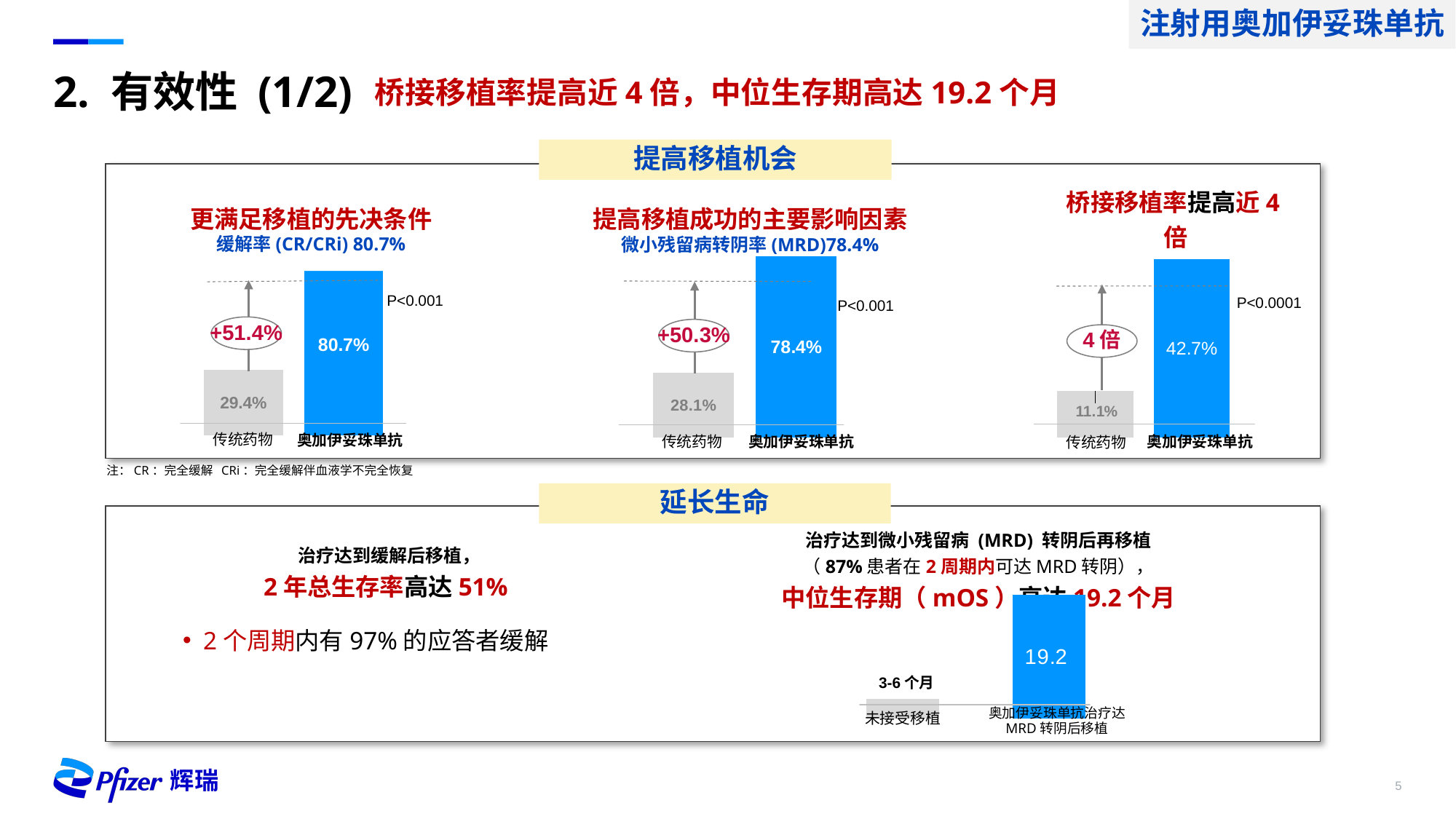
In the top-right chart (桥接移植率), which category has the higher value, 传统药物 or 奥加伊妥珠单抗? 奥加伊妥珠单抗 In the top-left chart (缓解率 CR/CRi), what is the value for 传统药物? 29.4% In the top-right chart (桥接移植率), what is the value for 奥加伊妥珠单抗? 42.7% In the top-middle chart (微小残留病转阴率 MRD), what is the value for 奥加伊妥珠单抗? 78.4% In the top-right chart (桥接移植率), what is the value for 传统药物? 11.1% In the top-middle chart (微小残留病转阴率 MRD), what is the difference between 奥加伊妥珠单抗 and 传统药物? +50.3% What kind of chart is the top-middle chart (微小残留病转阴率 MRD)? bar chart In the top-middle chart (微小残留病转阴率 MRD), what is the value for 传统药物? 28.1% In the top-left chart (缓解率 CR/CRi), what is the value for 奥加伊妥珠单抗? 80.7% In the top-left chart (缓解率 CR/CRi), what is the difference between 奥加伊妥珠单抗 and 传统药物? 51.3% In the bottom chart (中位生存期 mOS), what is the value for 奥加伊妥珠单抗治疗达MRD转阴后移植? 19.2 How many categories are shown in the top-left chart (缓解率 CR/CRi)? 2